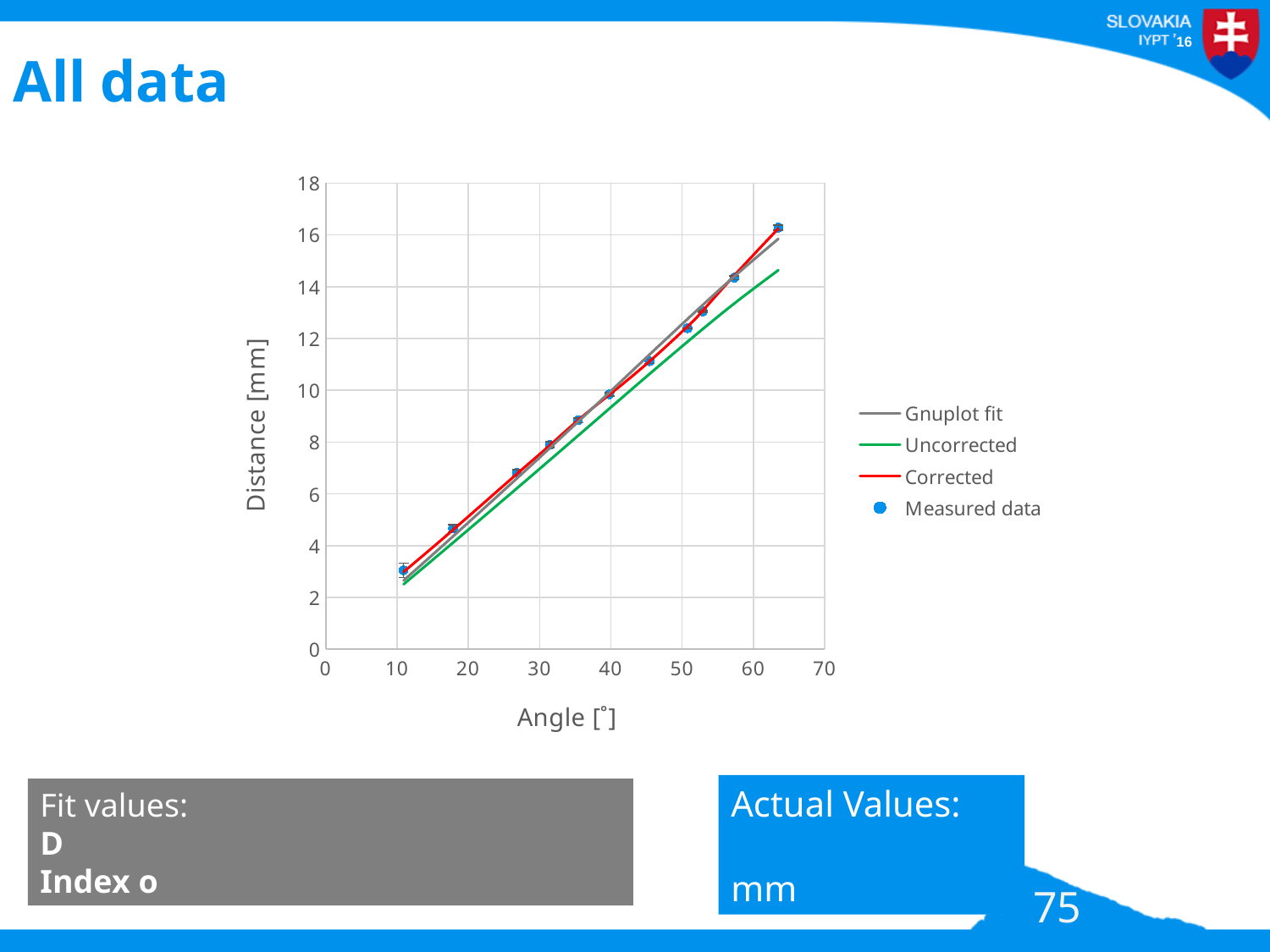
At 60°, which line is higher: Corrected or Uncorrected? Corrected What is the label of the x axis? Angle [°] Is the measured distance at the largest angle (around 63°) greater or less than 14 mm? greater Do the measured distance values rise or fall as the angle increases? rise Which of the three fitted lines is lowest at large angles (around 60°)? Uncorrected How many series does the legend list? 4 What kind of chart is shown on the slide? line chart with scatter points Is the measured distance at about 40° greater or less than 12 mm? less Is the measured distance at about 18° greater or less than 6 mm? less What colour is the Uncorrected line in the legend? green